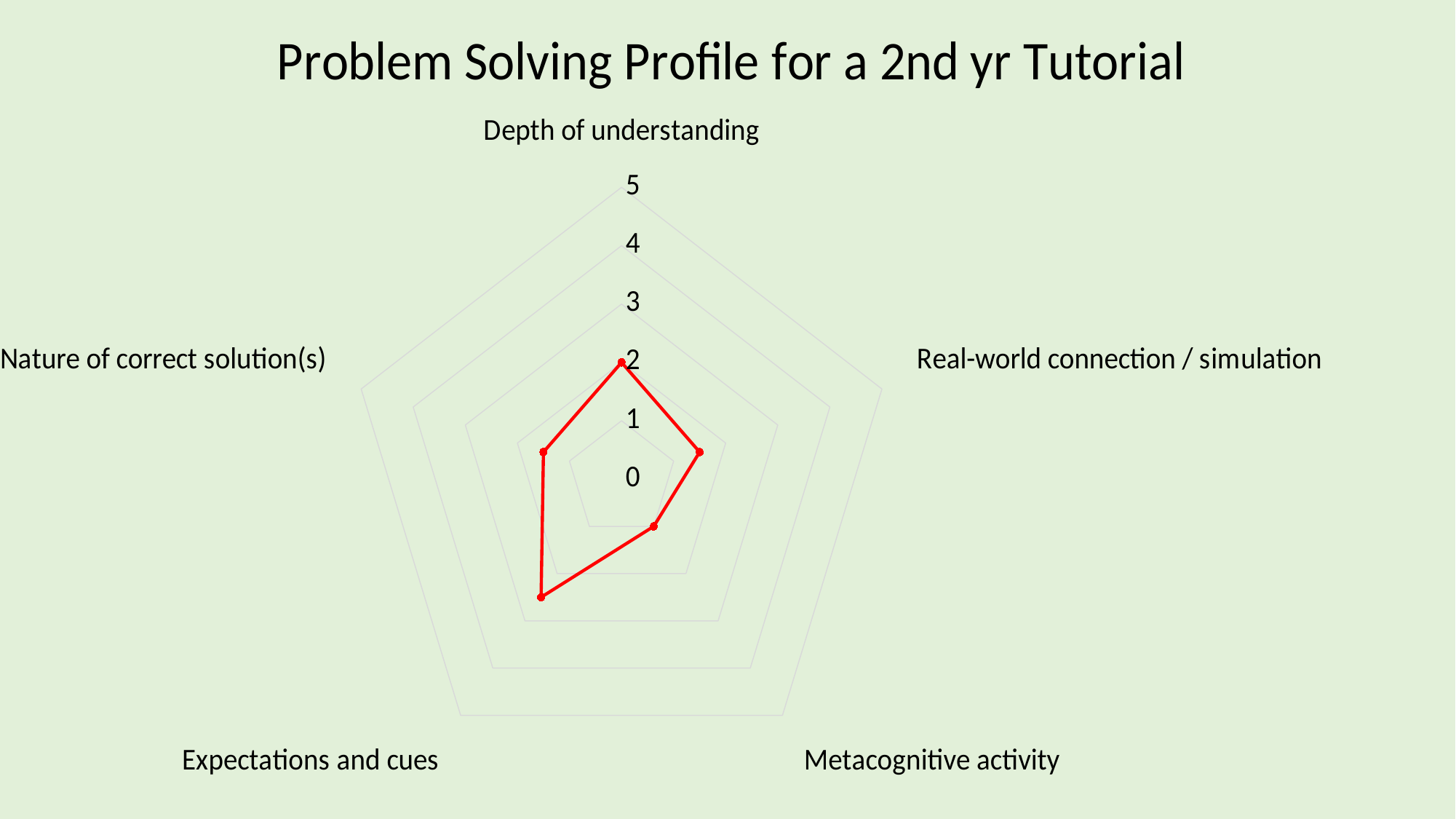
Is the value for Real-world connection / simulation greater or less than 2? less What is the maximum value shown on the chart's scale? 5 Which category has the lowest value? Metacognitive activity Which category has the highest value? Expectations and cues Which is larger, the value for Expectations and cues or the value for Depth of understanding? Expectations and cues How many categories (axes) does the radar chart have? 5 Is the value for Expectations and cues greater or less than 3? less Is the value for Expectations and cues greater or less than 2? greater What kind of chart is shown on the slide? Radar chart What is the title of the chart? Problem Solving Profile for a 2nd yr Tutorial What is the value for Depth of understanding? 2